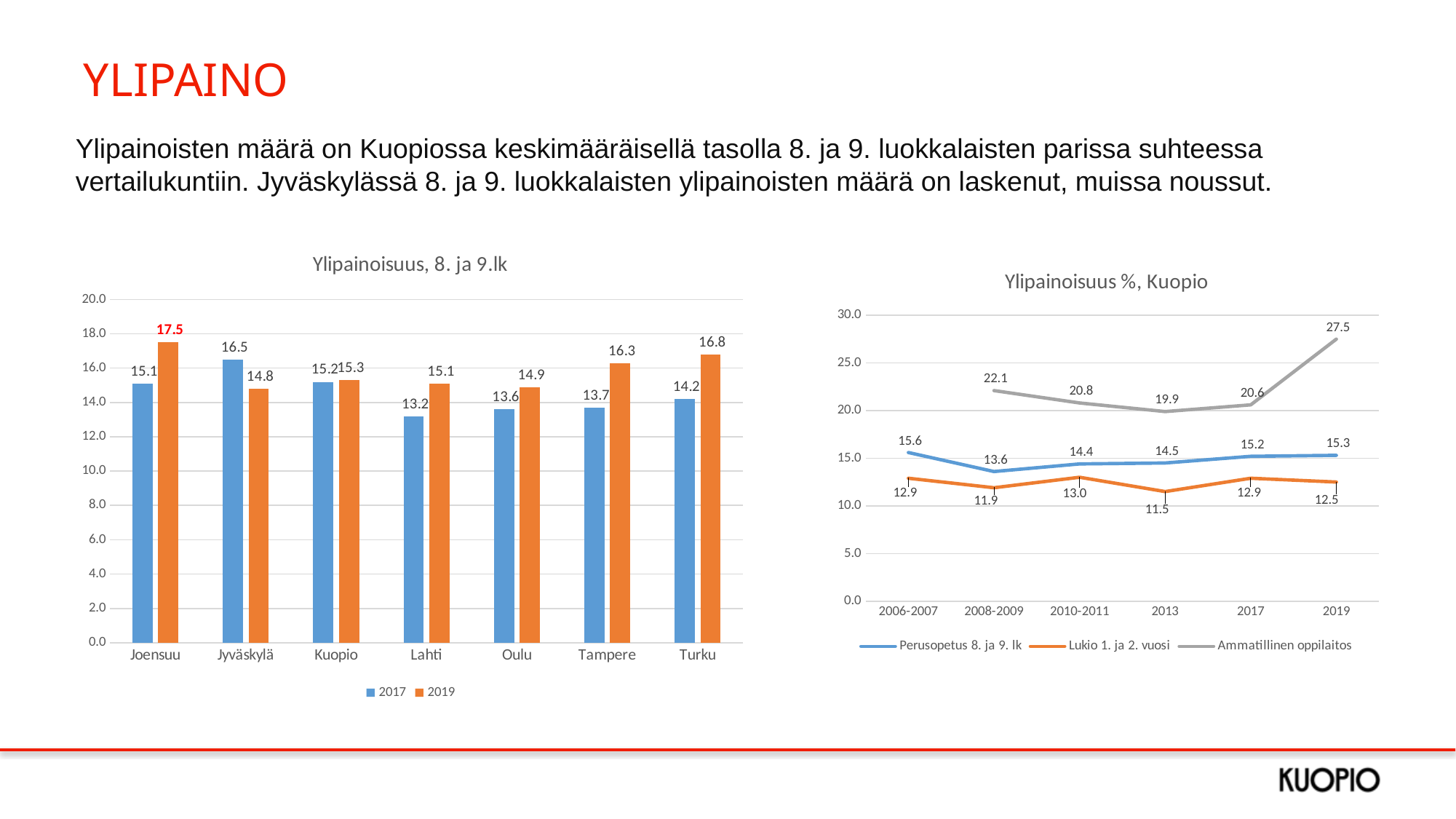
How many series does the legend list in the chart titled "Ylipainoisuus %, Kuopio"? 3 In the chart titled "Ylipainoisuus %, Kuopio", what is the value for Ammatillinen oppilaitos in 2019? 27.5 In the chart titled "Ylipainoisuus, 8. ja 9.lk", what is the 2019 value for Joensuu? 17.5 In the chart titled "Ylipainoisuus, 8. ja 9.lk", which city has the highest 2019 value? Joensuu In the chart titled "Ylipainoisuus, 8. ja 9.lk", which city has the lowest 2017 value? Lahti In the chart titled "Ylipainoisuus, 8. ja 9.lk", which is larger for Jyväskylä, the 2017 value or the 2019 value? 2017 In the chart titled "Ylipainoisuus %, Kuopio", what is the value for Lukio 1. ja 2. vuosi in 2013? 11.5 What type of chart is the chart titled "Ylipainoisuus, 8. ja 9.lk"? Bar chart How many cities are shown in the chart titled "Ylipainoisuus, 8. ja 9.lk"? 7 In the chart titled "Ylipainoisuus, 8. ja 9.lk", what is the difference between the 2019 and 2017 values for Turku? 2.6 In the chart titled "Ylipainoisuus %, Kuopio", what is the difference between the Ammatillinen oppilaitos values for 2019 and 2017? 6.9 In the chart titled "Ylipainoisuus, 8. ja 9.lk", what is the 2017 value for Lahti? 13.2